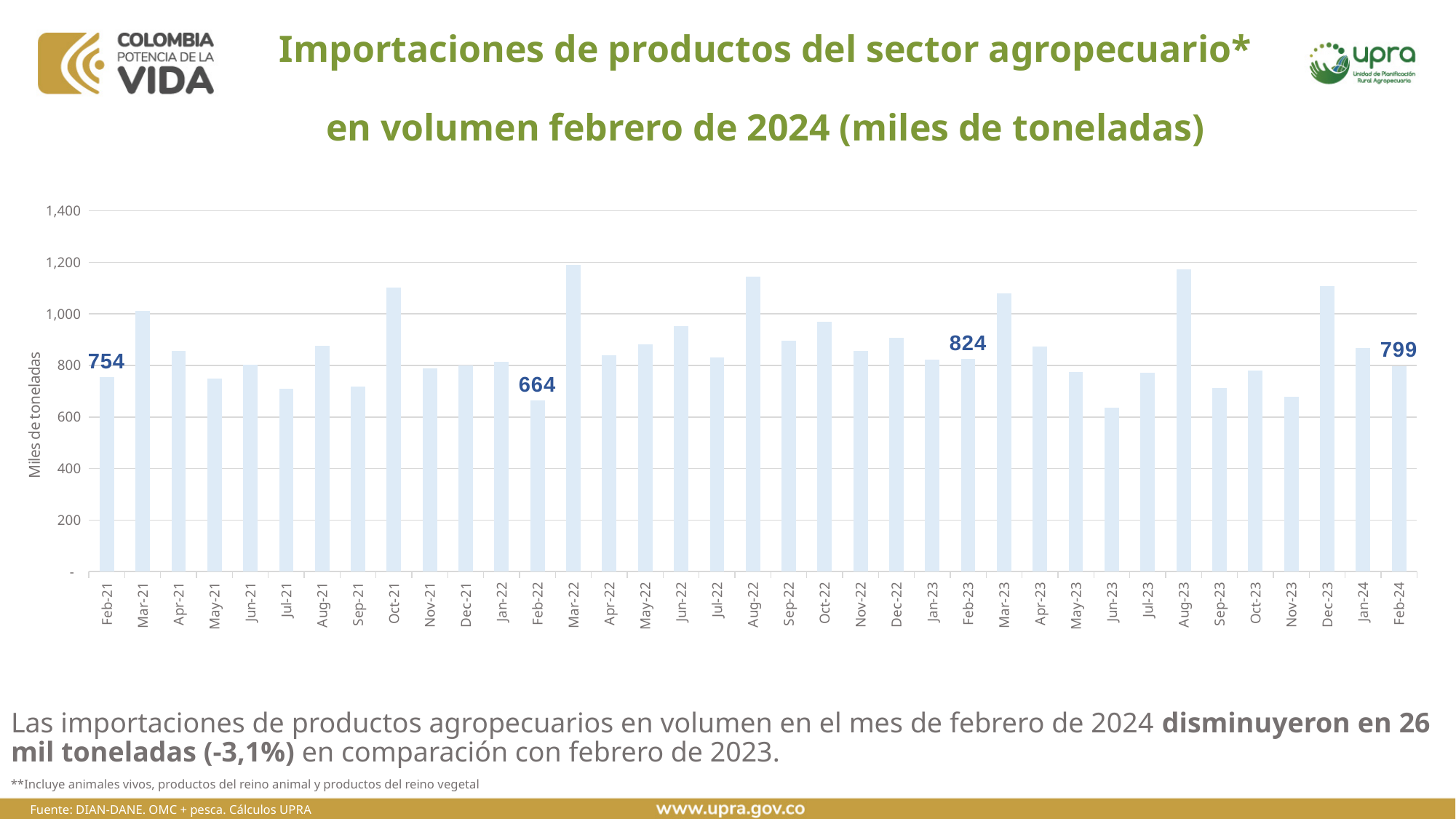
What kind of chart is shown on the slide? bar chart What is the value for Feb-23? 824 What is the difference between the values for Feb-23 and Feb-22? 160 What is the value for Feb-22? 664 Is the value for Oct-21 greater or less than 1,000? greater Is the value for Jun-23 greater or less than 800? less What is the value for Feb-24? 799 What is the value for Feb-21? 754 How many months are plotted on the chart? 37 Which is larger, the value for Feb-23 or the value for Feb-24? Feb-23 What is the difference between the values for Feb-21 and Feb-22? 90 Is the value for Mar-22 greater or less than 1,000? greater